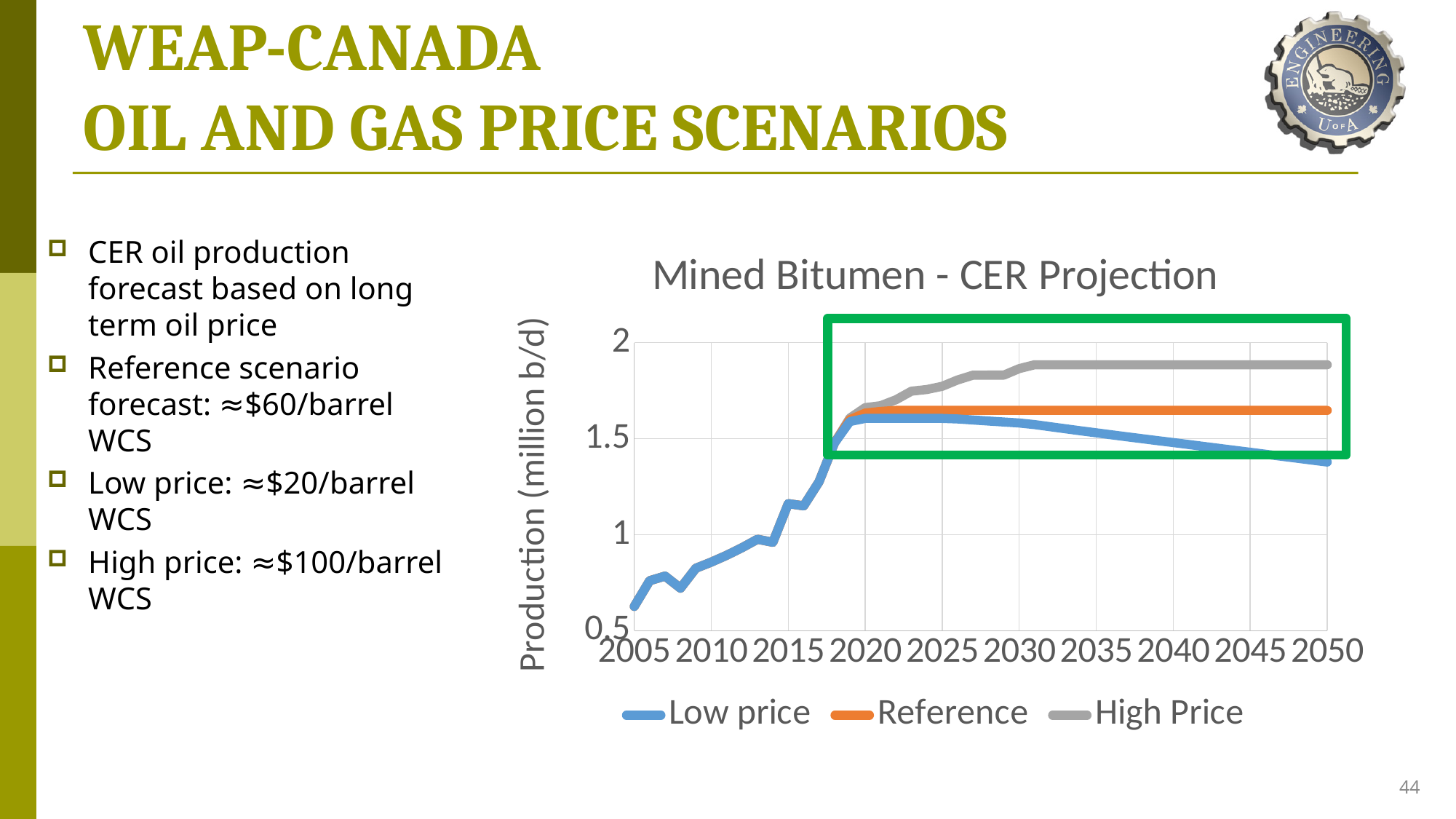
Which series has the highest production in 2050? High Price Which series has the lowest production in 2050? Low price Does the High Price series rise or fall between 2020 and 2030? rise Does the Low price series rise or fall between 2025 and 2050? fall Is the Low price value in 2050 greater or less than 1.5? less What kind of chart is shown on the slide? line chart In 2050, which is larger: the Reference value or the Low price value? Reference Is the production value in 2005 greater or less than 1? less What is the title of the chart? Mined Bitumen - CER Projection What is the label of the y axis of the chart? Production (million b/d) Is the High Price value in 2050 greater or less than 1.5? greater How many series does the chart's legend list? 3